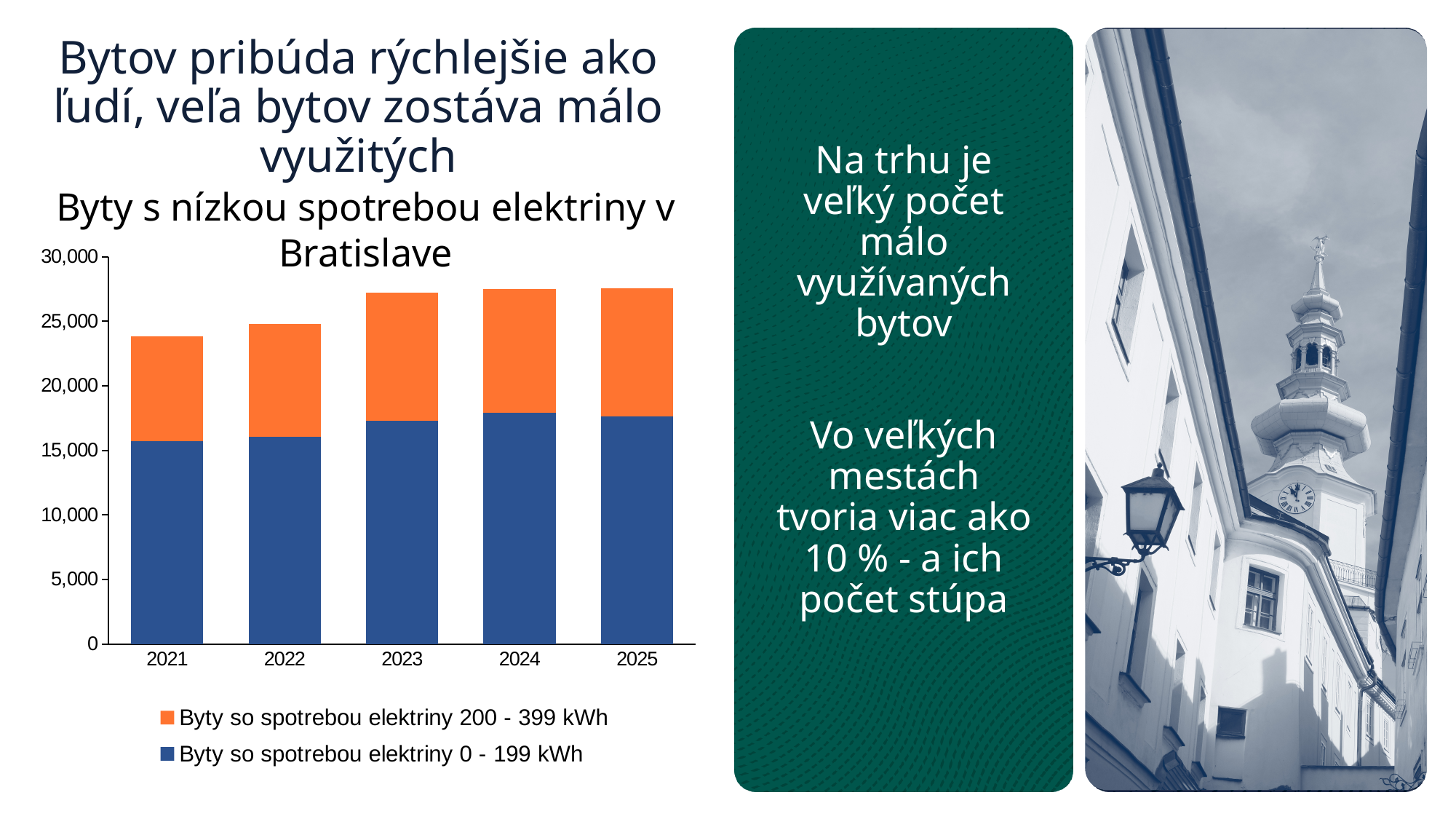
Which year has the lowest total stacked bar in the chart? 2021 Which series is shown in orange in the chart? Byty so spotrebou elektriny 200 - 399 kWh Is the total stacked bar for 2025 greater or less than 25,000? greater Do the total stacked bars generally rise or fall from 2021 to 2025? rise Is the value for 'Byty so spotrebou elektriny 0 - 199 kWh' in 2024 greater or less than 20,000? less What is the title of the chart? Byty s nízkou spotrebou elektriny v Bratislave Is the total stacked bar for 2021 greater or less than 25,000? less What type of chart is shown on the slide? Stacked bar chart Which year has the larger total stacked bar, 2021 or 2023? 2023 How many series does the chart's legend list? 2 How many years are shown on the x axis of the chart? 5